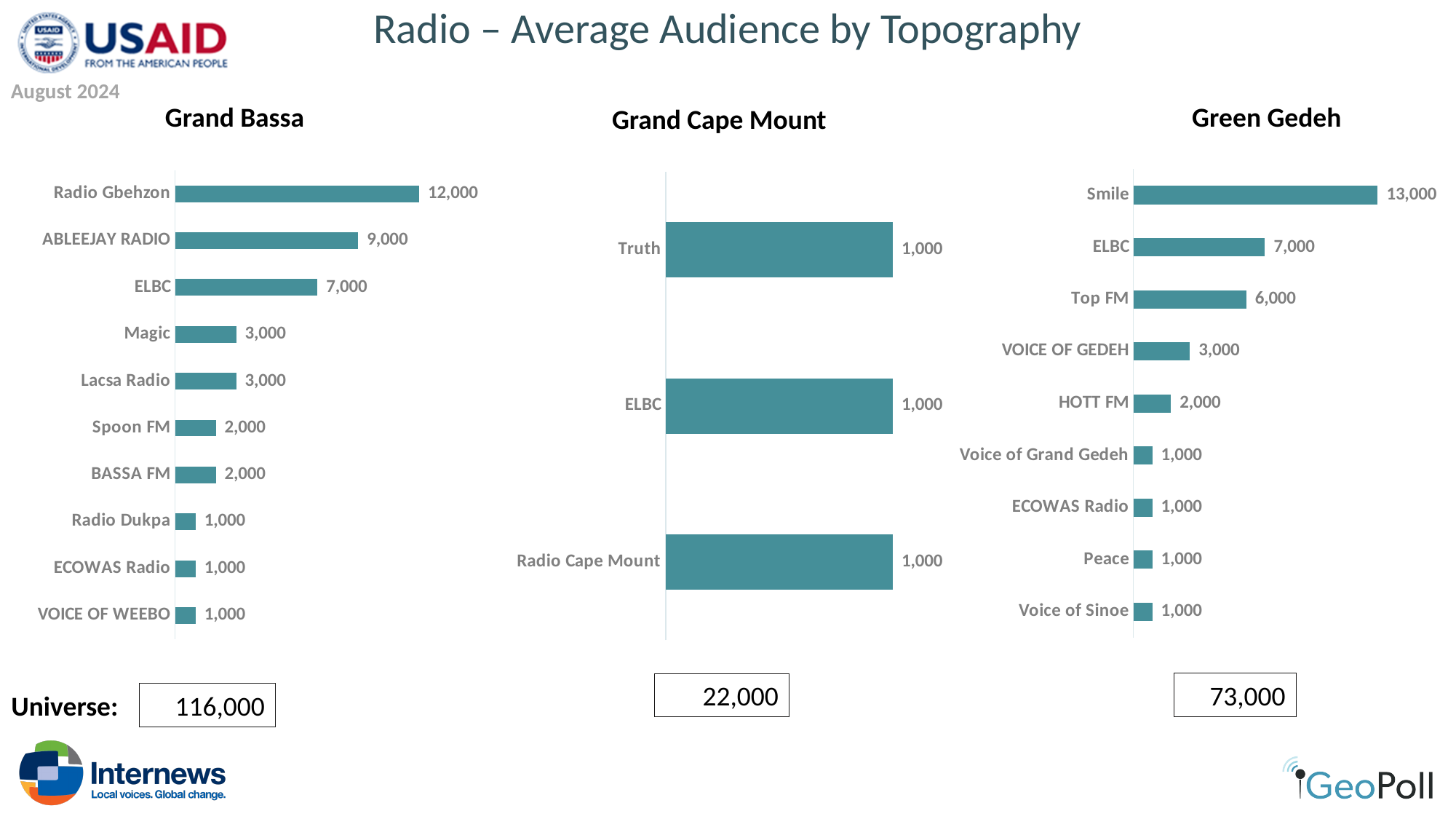
In the Green Gedeh chart, what is the average audience for Top FM? 6,000 In the Grand Bassa chart, how many stations are listed? 10 In the Green Gedeh chart, which is larger, ELBC or VOICE OF GEDEH? ELBC What kind of chart is the Grand Bassa chart? Bar chart What is the universe value shown below the Green Gedeh chart? 73,000 In the Grand Bassa chart, what is the difference between ABLEEJAY RADIO and ELBC? 2,000 In the Grand Cape Mount chart, how many stations are listed? 3 In the Grand Cape Mount chart, what is the average audience for Truth? 1,000 In the Grand Bassa chart, what is the average audience for Radio Gbehzon? 12,000 In the Green Gedeh chart, which station has the highest average audience? Smile In the Green Gedeh chart, what is the difference between Smile and HOTT FM? 11,000 In the Grand Bassa chart, which station has the highest average audience? Radio Gbehzon